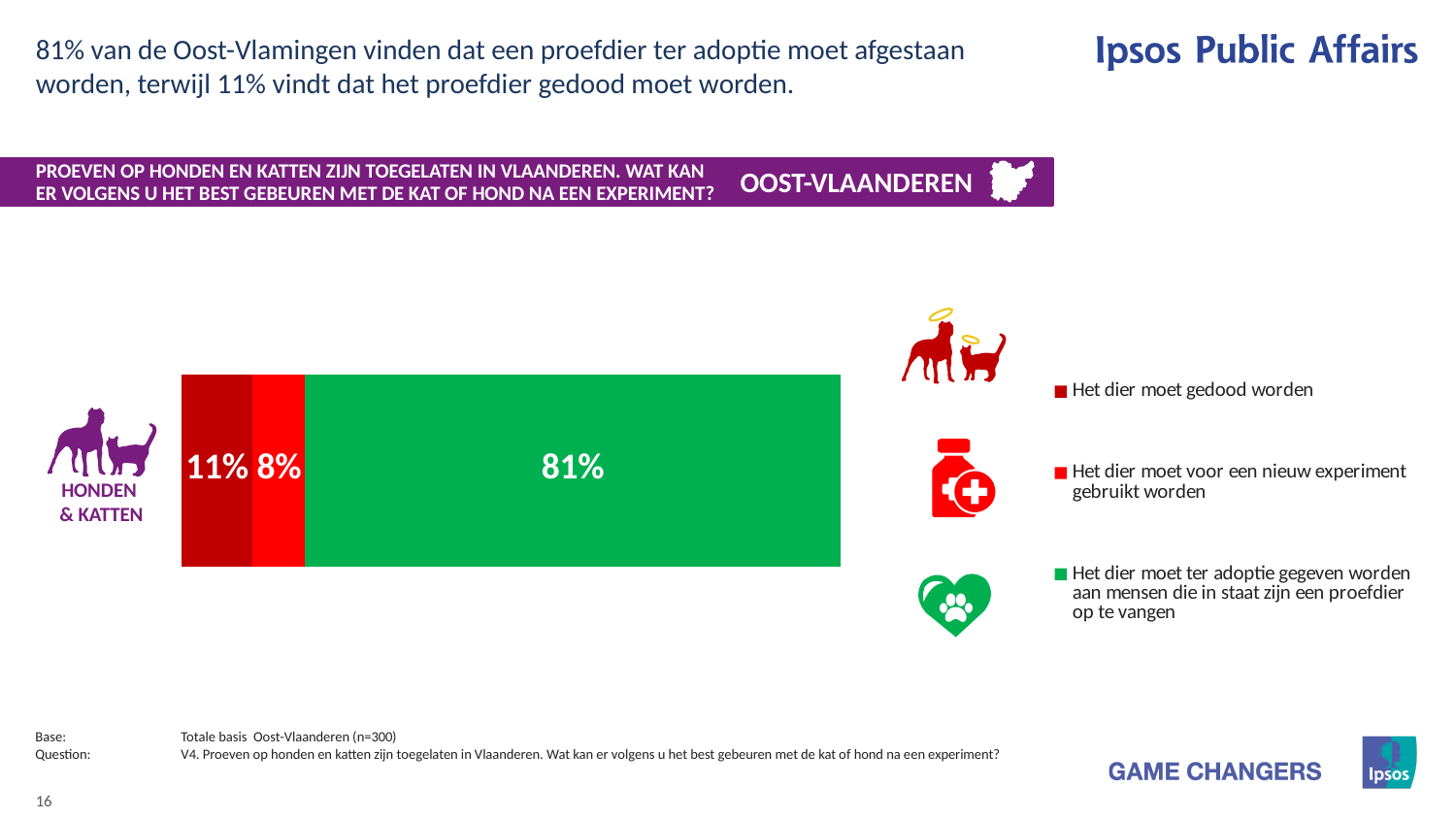
What colour is the segment for "Het dier moet ter adoptie gegeven worden"? Green What is the difference between the share for killing the animal and the share for using it in a new experiment? 3% What percentage of respondents say the animal should be killed ("Het dier moet gedood worden")? 11% What percentage of respondents say the animal should be given up for adoption? 81% How many series does the legend list? 3 What is the difference between the share for adoption (81%) and the share for killing the animal (11%)? 70% Which response option has the smallest share in the bar? Het dier moet voor een nieuw experiment gebruikt worden Which response option has the largest share in the bar? Het dier moet ter adoptie gegeven worden aan mensen die in staat zijn een proefdier op te vangen Which is larger: the share for "Het dier moet gedood worden" or the share for "Het dier moet voor een nieuw experiment gebruikt worden"? Het dier moet gedood worden What percentage of respondents say the animal should be used for a new experiment? 8% What kind of chart is shown on the slide? Stacked bar chart What is the total of the three segments in the stacked bar? 100%